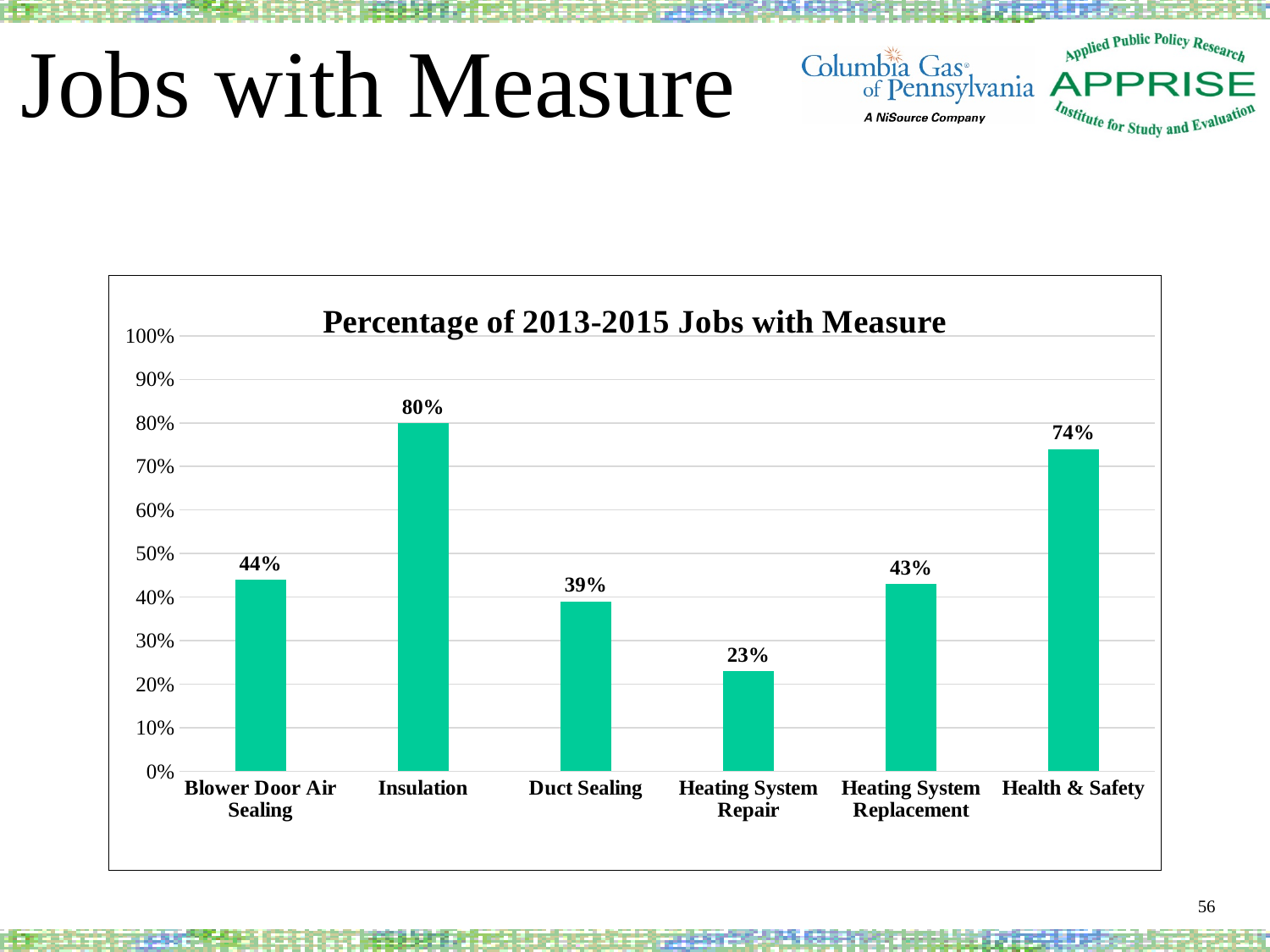
What percentage of jobs included Heating System Repair? 23% What is the difference in percentage points between Health & Safety and Heating System Repair? 51 How many measure categories are shown on the chart? 6 What is the title of the chart? Percentage of 2013-2015 Jobs with Measure What is the value shown for Health & Safety? 74% What type of chart is shown on the slide? Bar chart Which is larger, the value for Blower Door Air Sealing or the value for Heating System Replacement? Blower Door Air Sealing Which measure has the highest percentage of jobs? Insulation Is the value for Health & Safety greater or less than 70%? greater What is the difference in percentage points between Insulation and Duct Sealing? 41 What percentage of 2013-2015 jobs included Insulation? 80% Which measure has the lowest percentage of jobs? Heating System Repair